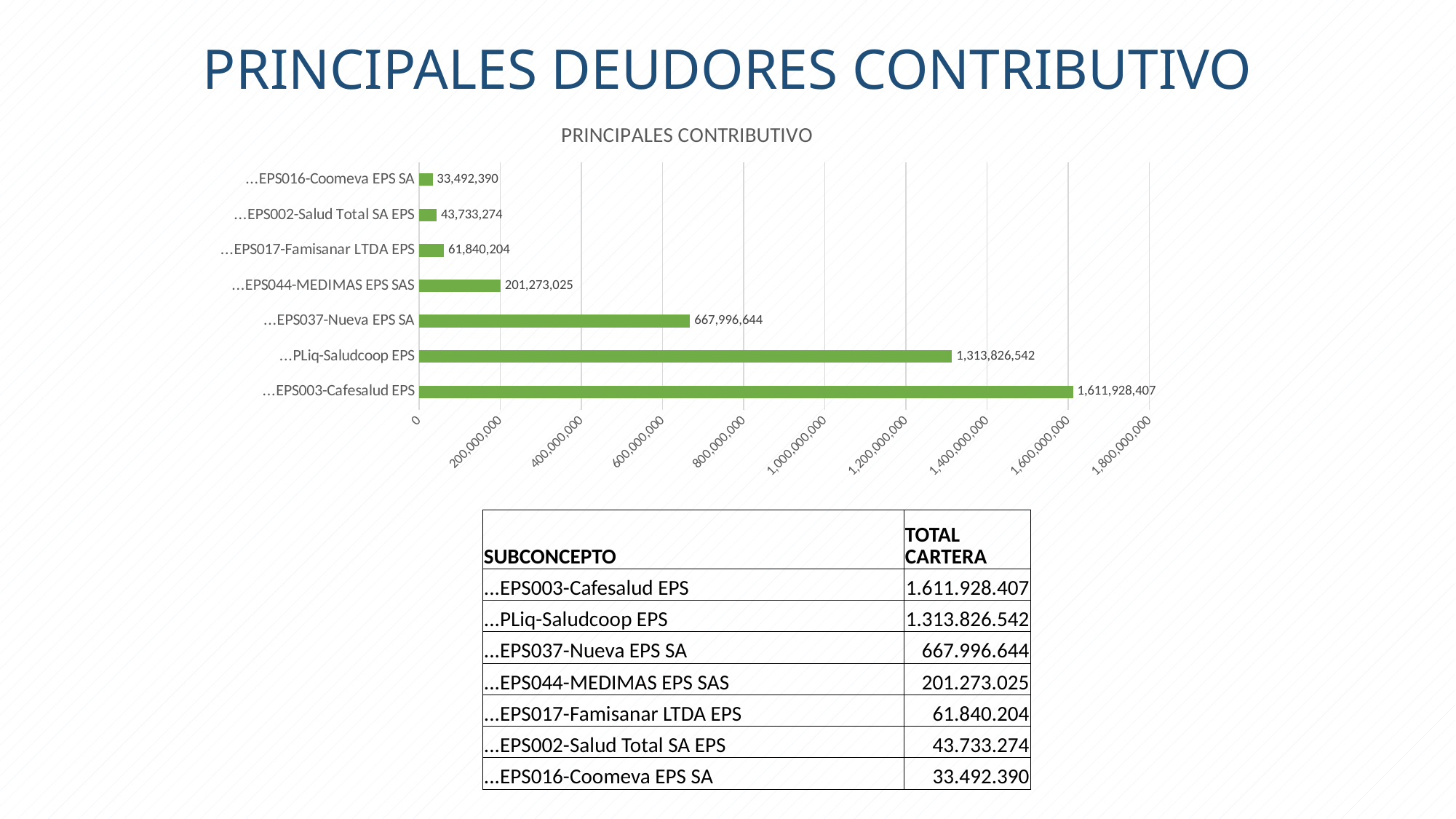
Which category has the lowest value? ...EPS016-Coomeva EPS SA What is the value for ...EPS037-Nueva EPS SA? 667,996,644 How many categories are shown in the chart? 7 What kind of chart is shown on the slide? bar chart What colour are the bars in the chart? green What is the value for ...EPS016-Coomeva EPS SA? 33,492,390 What is the value for ...EPS003-Cafesalud EPS? 1,611,928,407 Which is larger, the value for ...EPS044-MEDIMAS EPS SAS or ...EPS017-Famisanar LTDA EPS? ...EPS044-MEDIMAS EPS SAS What is the title of the chart? PRINCIPALES CONTRIBUTIVO Is the value for ...PLiq-Saludcoop EPS greater or less than 1,200,000,000? greater What is the difference between the values for ...EPS003-Cafesalud EPS and ...PLiq-Saludcoop EPS? 298,101,865 Which category has the highest value? ...EPS003-Cafesalud EPS